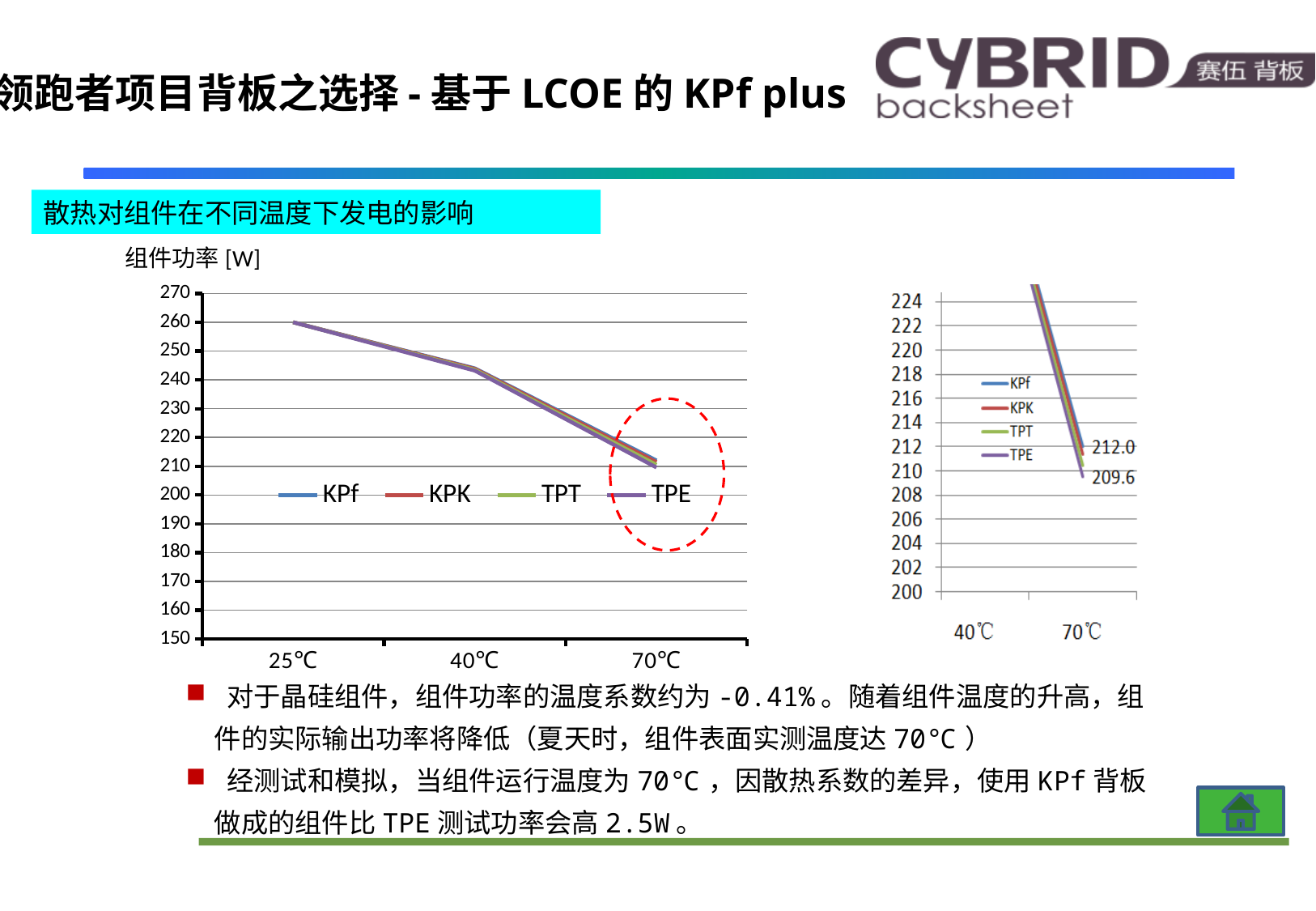
How many temperature categories are shown on the x axis of the left chart? 3 In the zoomed chart on the right, what is the higher labelled value at 70℃? 212.0 In the left chart, is the value for KPK at 40℃ greater or less than 250? less In the left chart, is the value for KPf at 25℃ greater or less than 250? greater In the left chart, do the values rise or fall as temperature increases from 25℃ to 70℃? fall In the zoomed chart on the right, what is the lower labelled value at 70℃? 209.6 How many series does the legend of the left chart list? 4 In the zoomed chart on the right, what is the difference between the two labelled values at 70℃ (212.0 and 209.6)? 2.4 In the left chart, which temperature category has the lowest module power? 70℃ What is the y-axis label of the left chart? 组件功率 [W] What kind of chart is the large chart on the left of the slide? line chart In the left chart, is the value for TPE at 70℃ greater or less than 220? less